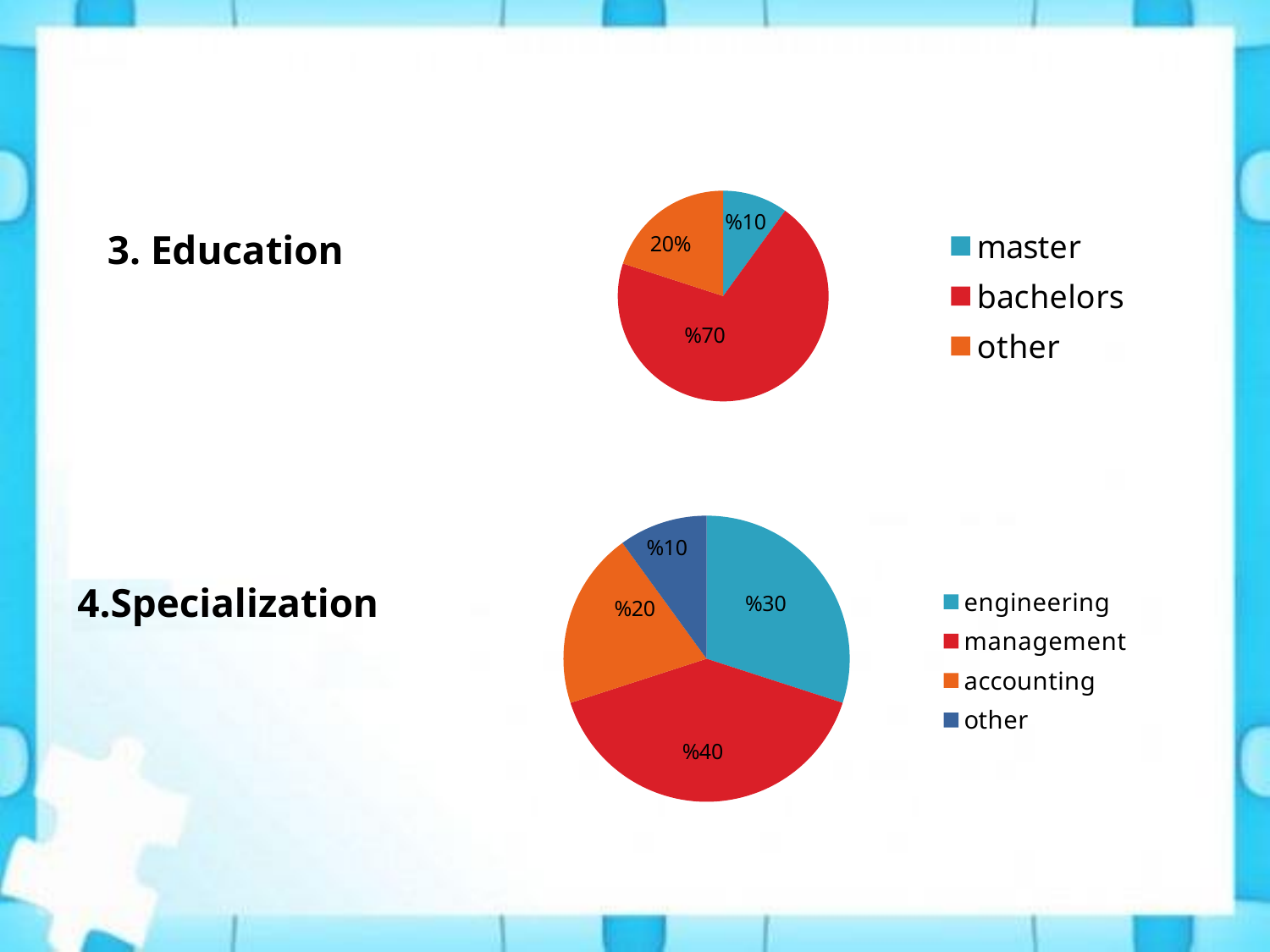
In the Education pie chart, which category has the largest slice? bachelors In the Specialization pie chart, which category has the largest slice? management In the Education pie chart, what share is labelled for other? 20% In the Education pie chart, what share is labelled for bachelors? %70 In the Specialization pie chart, which is larger, engineering or accounting? engineering In the Education pie chart, which category has the smallest slice? master In the Specialization pie chart, what share is labelled for management? %40 In the Specialization pie chart, which category has the smallest slice? other What type of chart is used for the Specialization data? pie chart In the Education pie chart, what share is labelled for master? %10 In the Education pie chart, how many categories does the legend list? 3 In the Specialization pie chart, what share is labelled for accounting? %20